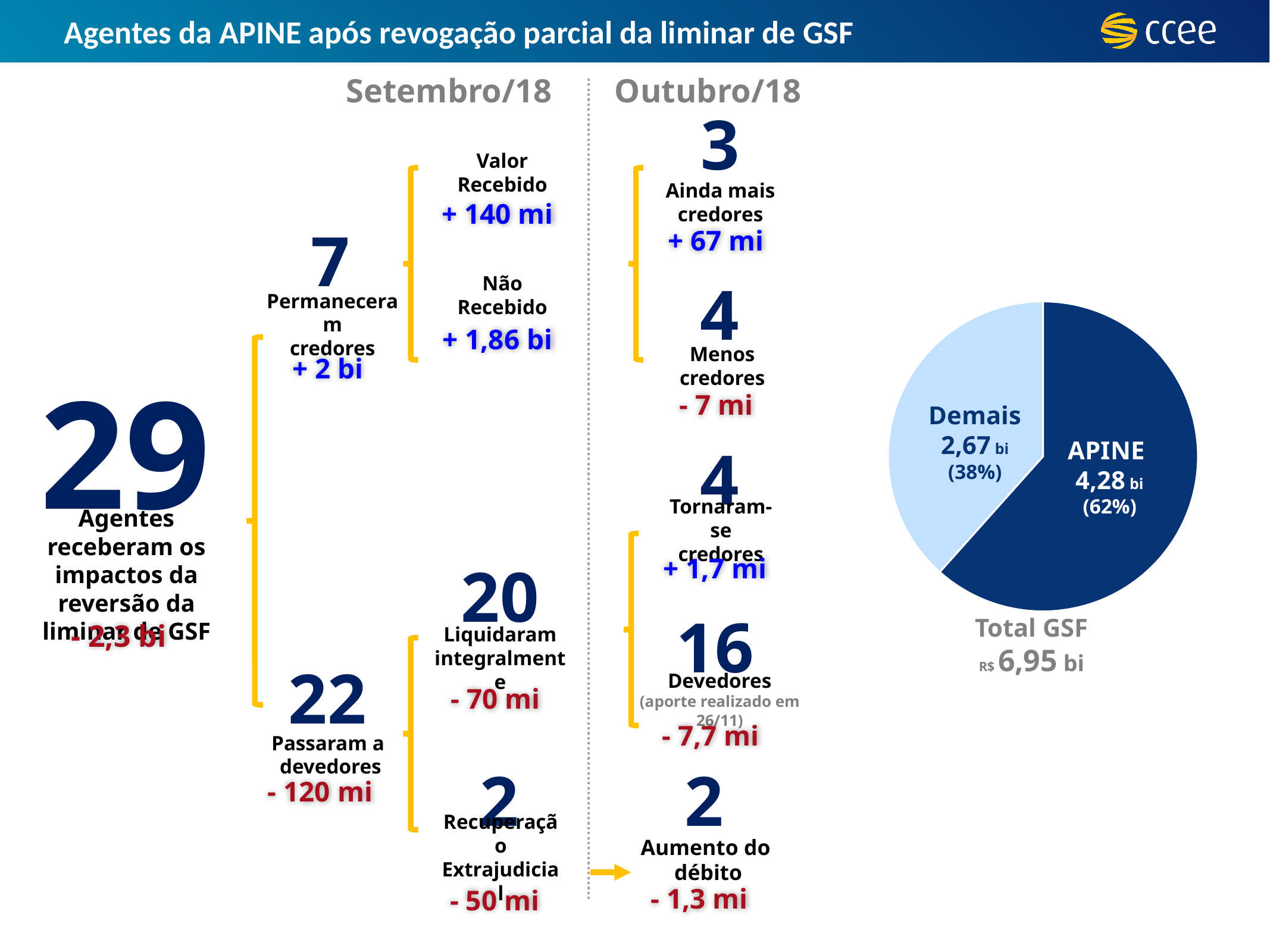
What share of the pie does the APINE slice represent? 62% What share of the pie does the Demais slice represent? 38% How many slices does the pie chart have? 2 What value is shown for the Demais slice of the pie chart? 2,67 bi What total is shown below the pie chart for Total GSF? R$ 6,95 bi What value is shown for the APINE slice of the pie chart? 4,28 bi Which slice of the pie chart is the smallest? Demais Which slice of the pie chart is drawn in dark blue? APINE What is the difference between the APINE and Demais values in the pie chart? 1,61 bi Which slice of the pie chart is the largest? APINE What kind of chart is shown on the right side of the slide? pie chart In the pie chart, which is larger: APINE or Demais? APINE